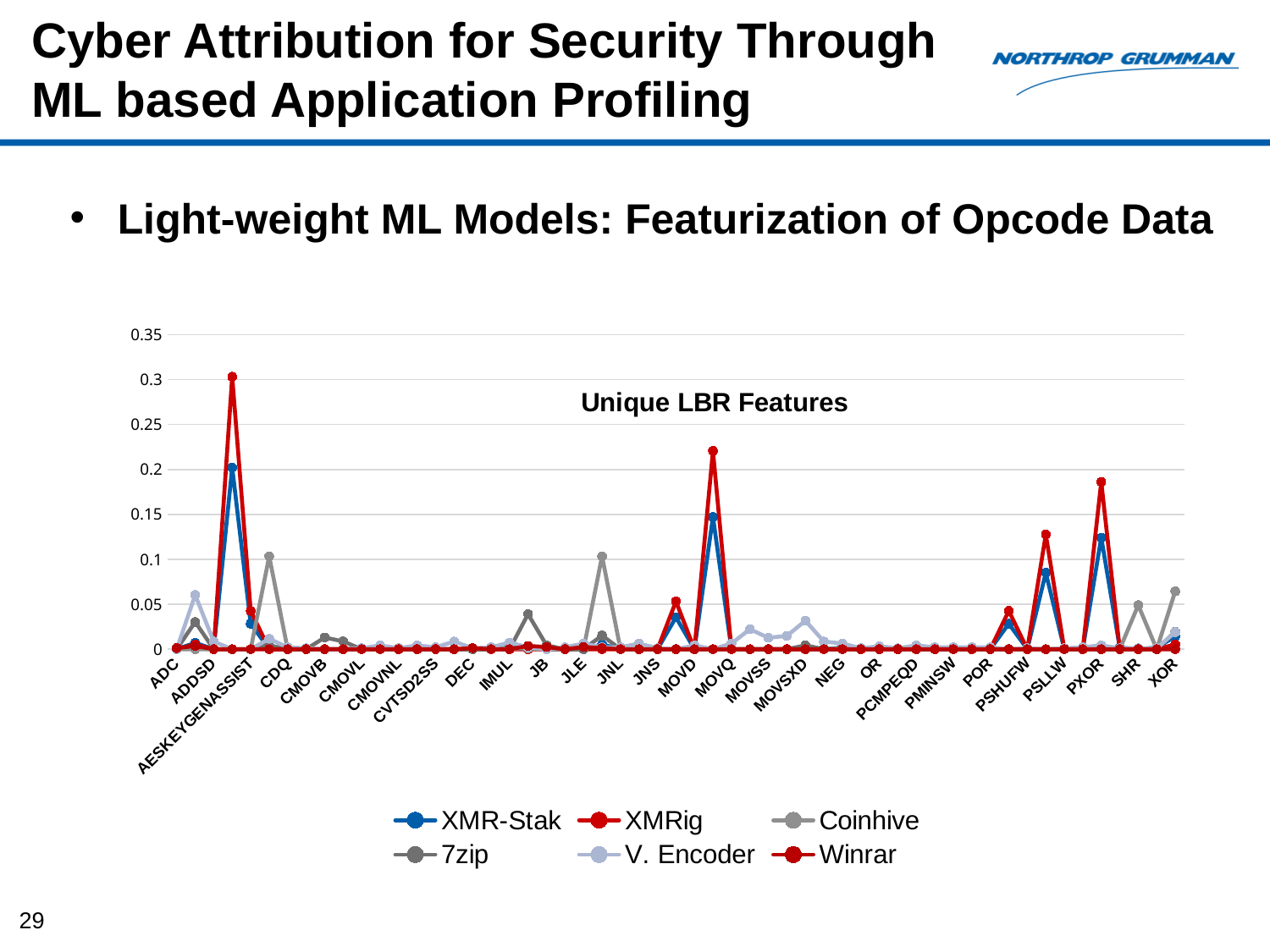
Which series reaches a higher peak value, XMR-Stak or Coinhive? XMR-Stak What is the title of the chart? Unique LBR Features What is the first category on the x axis? ADC What is the highest value shown on the y axis? 0.35 How many series does the legend list? 6 Is the highest value reached by the V. Encoder series greater or less than 0.1? less What kind of chart is shown on the slide? line chart Is the highest value reached by the XMR-Stak series greater or less than 0.25? less Is the highest value reached by the XMR-Stak series greater or less than 0.15? greater Which series reaches a higher peak value, Coinhive or V. Encoder? Coinhive Which series are listed in the chart legend? XMR-Stak, XMRig, Coinhive, 7zip, V. Encoder, Winrar